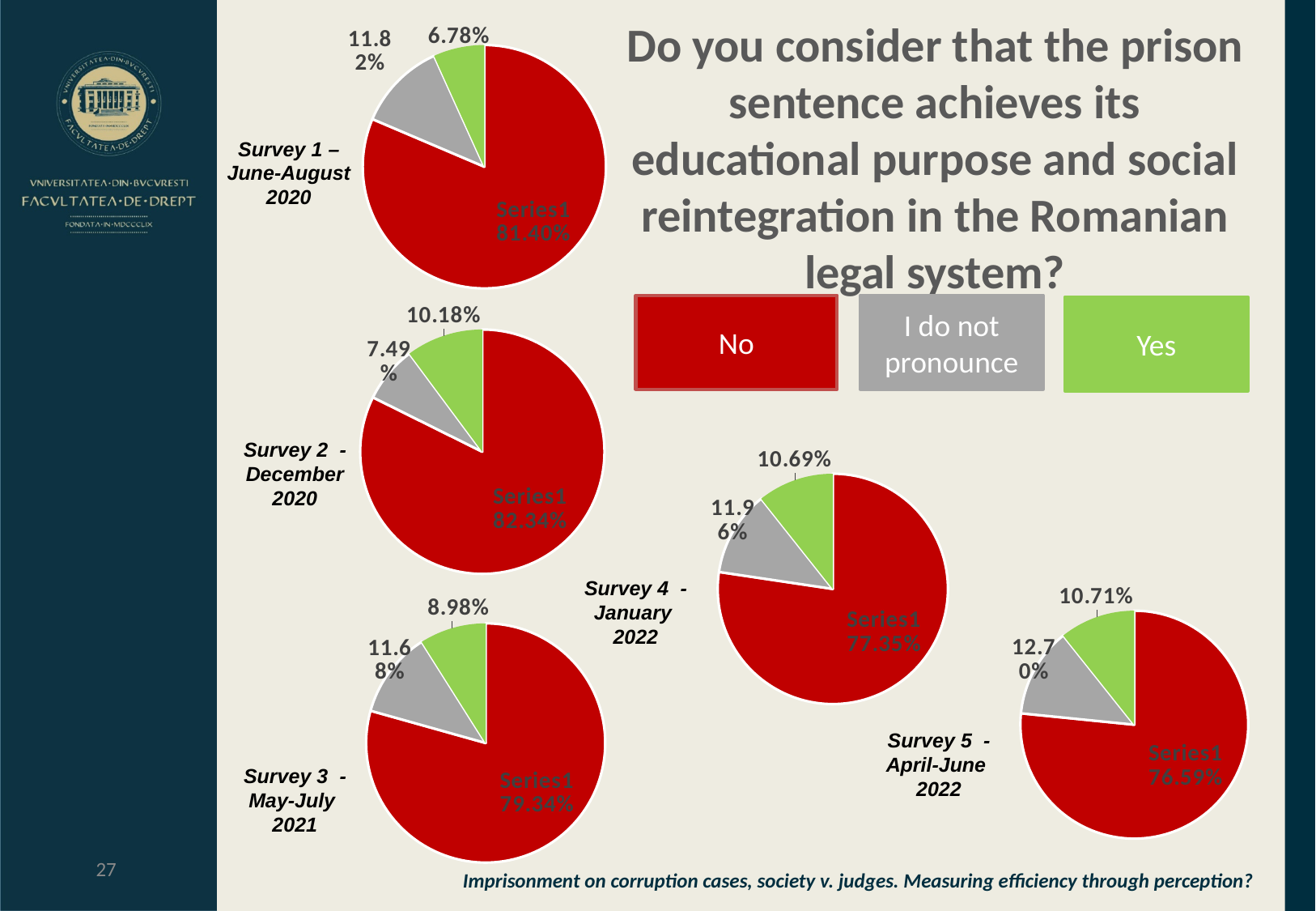
In the Survey 3 - May-July 2021 pie chart, what percentage answered "Yes"? 8.98% In the Survey 1 – June-August 2020 pie chart, which is larger: the "I do not pronounce" share or the "Yes" share? I do not pronounce In the Survey 1 – June-August 2020 pie chart, what percentage answered "Yes"? 6.78% In the Survey 4 - January 2022 pie chart, what percentage answered "No"? 77.35% In the Survey 2 - December 2020 pie chart, what is the difference between the "Yes" share and the "I do not pronounce" share? 2.69% In the Survey 5 - April-June 2022 pie chart, what percentage answered "I do not pronounce"? 12.70% In the Survey 1 – June-August 2020 pie chart, what percentage of respondents answered "No"? 81.40% What kind of chart is used to show the survey results on this slide? Pie chart In the Survey 5 - April-June 2022 pie chart, which answer has the largest share? No In the Survey 2 - December 2020 pie chart, which answer has the smallest share? I do not pronounce How many pie charts are shown on the slide? 5 In the Survey 2 - December 2020 pie chart, what percentage answered "I do not pronounce"? 7.49%